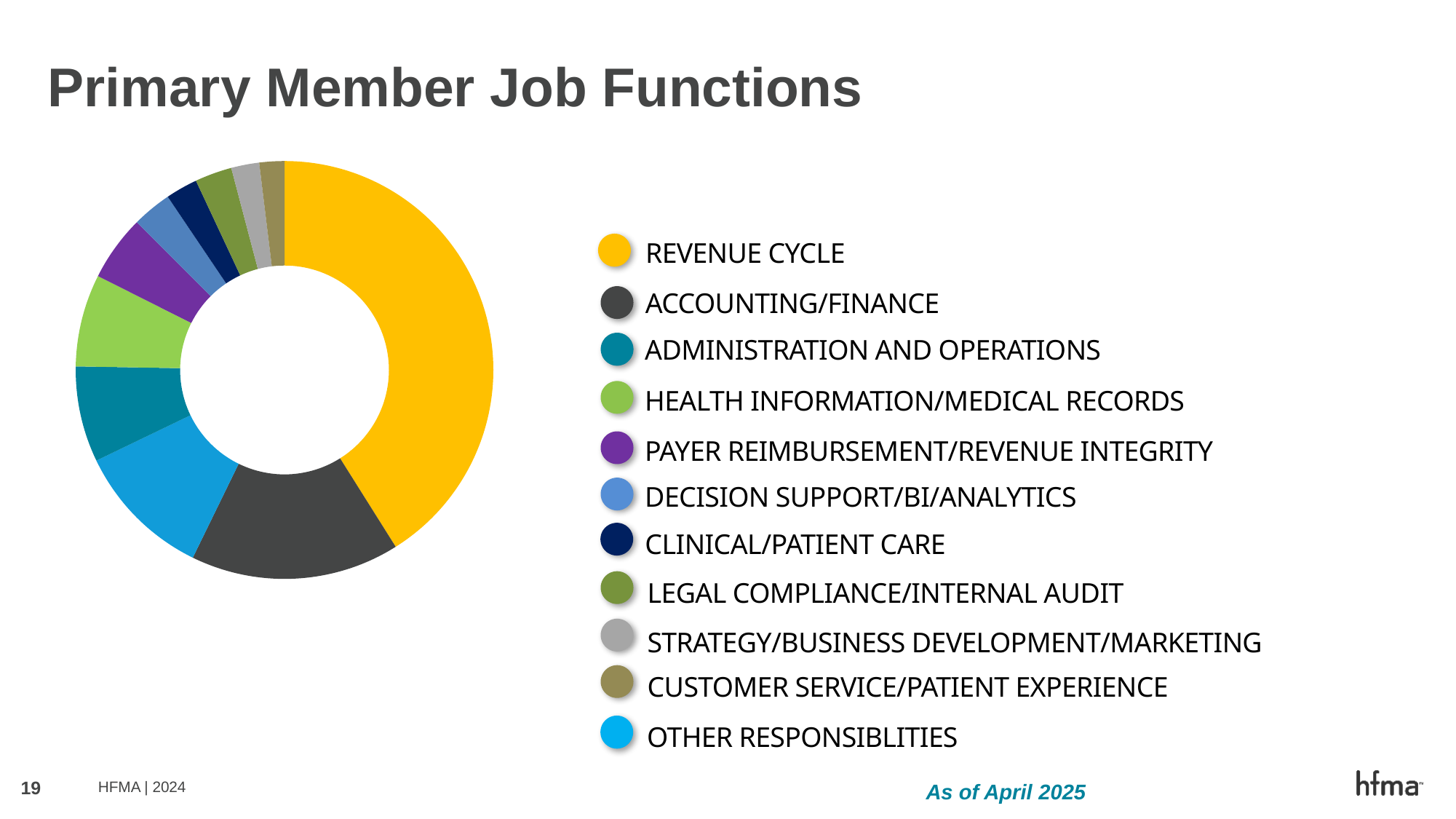
What is the title of the slide's chart? Primary Member Job Functions How many job function categories does the legend list? 11 Which job function has the largest slice of the chart? Revenue Cycle Which slice is larger, Administration and Operations or Decision Support/BI/Analytics? Administration and Operations Which slice is larger, Health Information/Medical Records or Payer Reimbursement/Revenue Integrity? Health Information/Medical Records Is the Revenue Cycle slice greater or less than half of the chart? less Which slice is larger, Other Responsiblities or Clinical/Patient Care? Other Responsiblities What kind of chart is shown on the slide? Pie chart (donut) What colour represents Revenue Cycle in the chart? Yellow